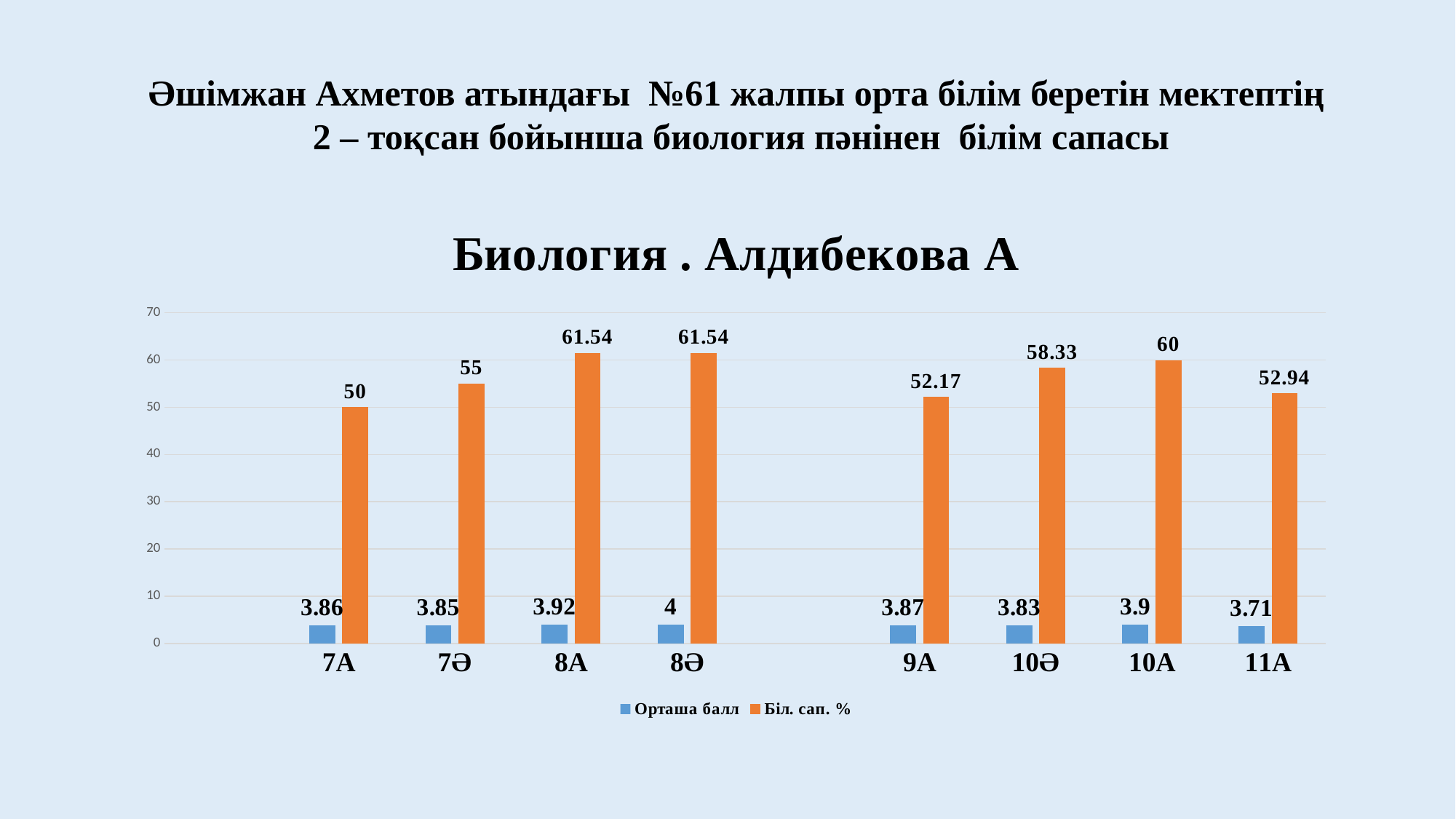
What kind of chart is shown on the slide? bar chart Which is larger, the Біл. сап. % value for 10Ә or for 11А? 10Ә What is the Біл. сап. % value for 8А? 61.54 How many series does the legend list? 2 How many class labels are shown on the x axis? 8 Which class has the highest Орташа балл value? 8Ә Is the Біл. сап. % value for 7Ә greater or less than 50? greater What is the Орташа балл value for 10Ә? 3.83 Which class has the lowest Орташа балл value? 11А Which class has the lowest Біл. сап. % value? 7А What is the Біл. сап. % value for 9А? 52.17 What is the difference between the Біл. сап. % values for 10А and 7Ә? 5